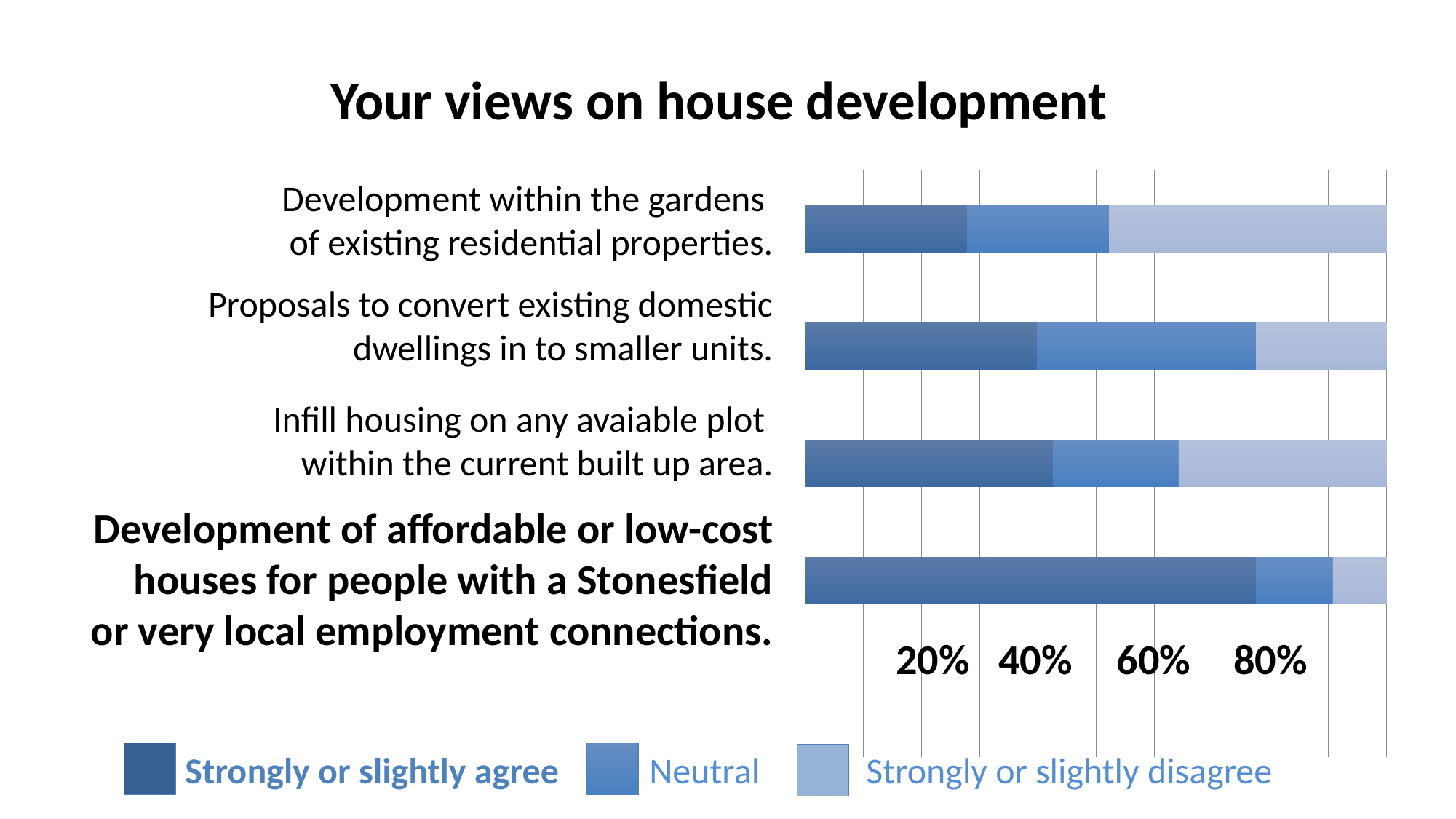
How many series does the legend list? 3 Is the 'Strongly or slightly agree' share for 'Development within the gardens of existing residential properties' greater or less than 40%? less Which legend entry is shown in the darkest blue? Strongly or slightly agree How many categories (statements) are plotted in the chart? 4 Is the 'Strongly or slightly disagree' share for 'Development of affordable or low-cost houses' greater or less than 20%? less Is the 'Strongly or slightly agree' share for 'Development of affordable or low-cost houses' greater or less than 60%? greater What is the title of the chart? Your views on house development Which statement has the largest 'Strongly or slightly disagree' share? Development within the gardens of existing residential properties. Which has a larger 'Strongly or slightly disagree' share: 'Development within the gardens of existing residential properties' or 'Proposals to convert existing domestic dwellings in to smaller units'? Development within the gardens of existing residential properties. Which statement has the smallest 'Strongly or slightly agree' share? Development within the gardens of existing residential properties. What kind of chart is shown on the slide? Stacked bar chart Which statement has the largest 'Strongly or slightly agree' share? Development of affordable or low-cost houses for people with a Stonesfield or very local employment connections.